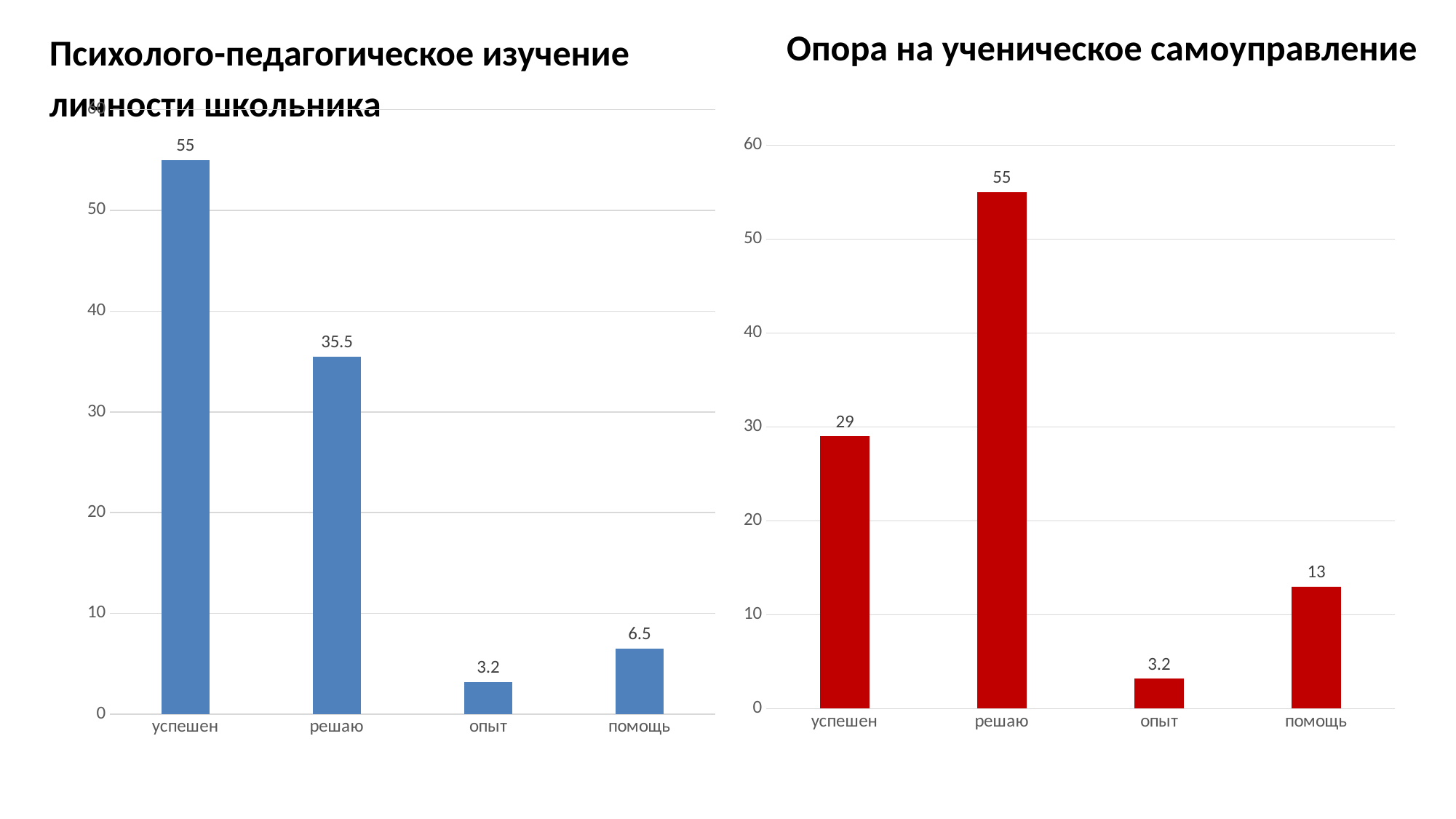
In the right chart (Опора на ученическое самоуправление), what is the value for помощь? 13 In the right chart (Опора на ученическое самоуправление), what is the difference between the values for решаю and успешен? 26 In the right chart (Опора на ученическое самоуправление), which category has the highest value? решаю How many categories are shown in the left chart (Психолого-педагогическое изучение личности школьника)? 4 In the left chart (Психолого-педагогическое изучение личности школьника), which category has the lowest value? опыт In the left chart (Психолого-педагогическое изучение личности школьника), what is the value for решаю? 35.5 What kind of chart is the right chart (Опора на ученическое самоуправление)? bar chart In the right chart (Опора на ученическое самоуправление), what is the value for успешен? 29 In the left chart (Психолого-педагогическое изучение личности школьника), what is the value for успешен? 55 In the right chart (Опора на ученическое самоуправление), which is larger, the value for помощь or the value for опыт? помощь In the left chart (Психолого-педагогическое изучение личности школьника), what is the difference between the values for успешен and решаю? 19.5 What colour are the bars in the right chart (Опора на ученическое самоуправление)? red